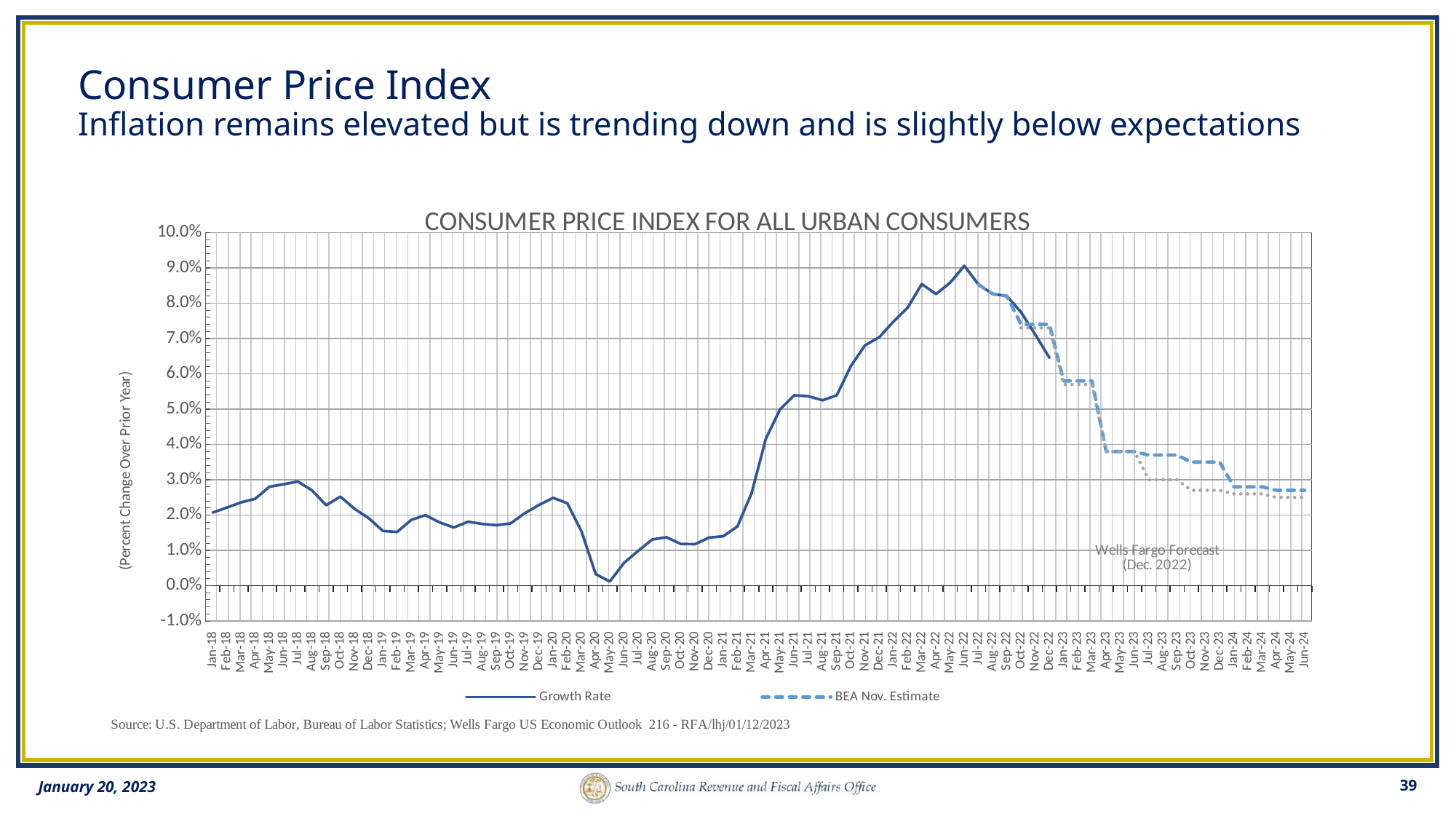
What kind of chart is shown on the slide? line chart Does the Growth Rate line rise or fall between Jun-22 and Dec-22? fall Is the Growth Rate value for Dec-22 greater or less than 6.0%? greater How many series does the chart legend list? 2 What are the two series named in the chart legend? Growth Rate and BEA Nov. Estimate Is the Growth Rate value for May-20 greater or less than 1.0%? less Is the Growth Rate value for Jul-18 greater or less than 4.0%? less Which is larger, the Growth Rate for Jun-22 or for Jul-18? Jun-22 In which month does the Growth Rate line reach its lowest value? May-20 What is the title of the chart? CONSUMER PRICE INDEX FOR ALL URBAN CONSUMERS In which month does the Growth Rate line reach its highest value? Jun-22